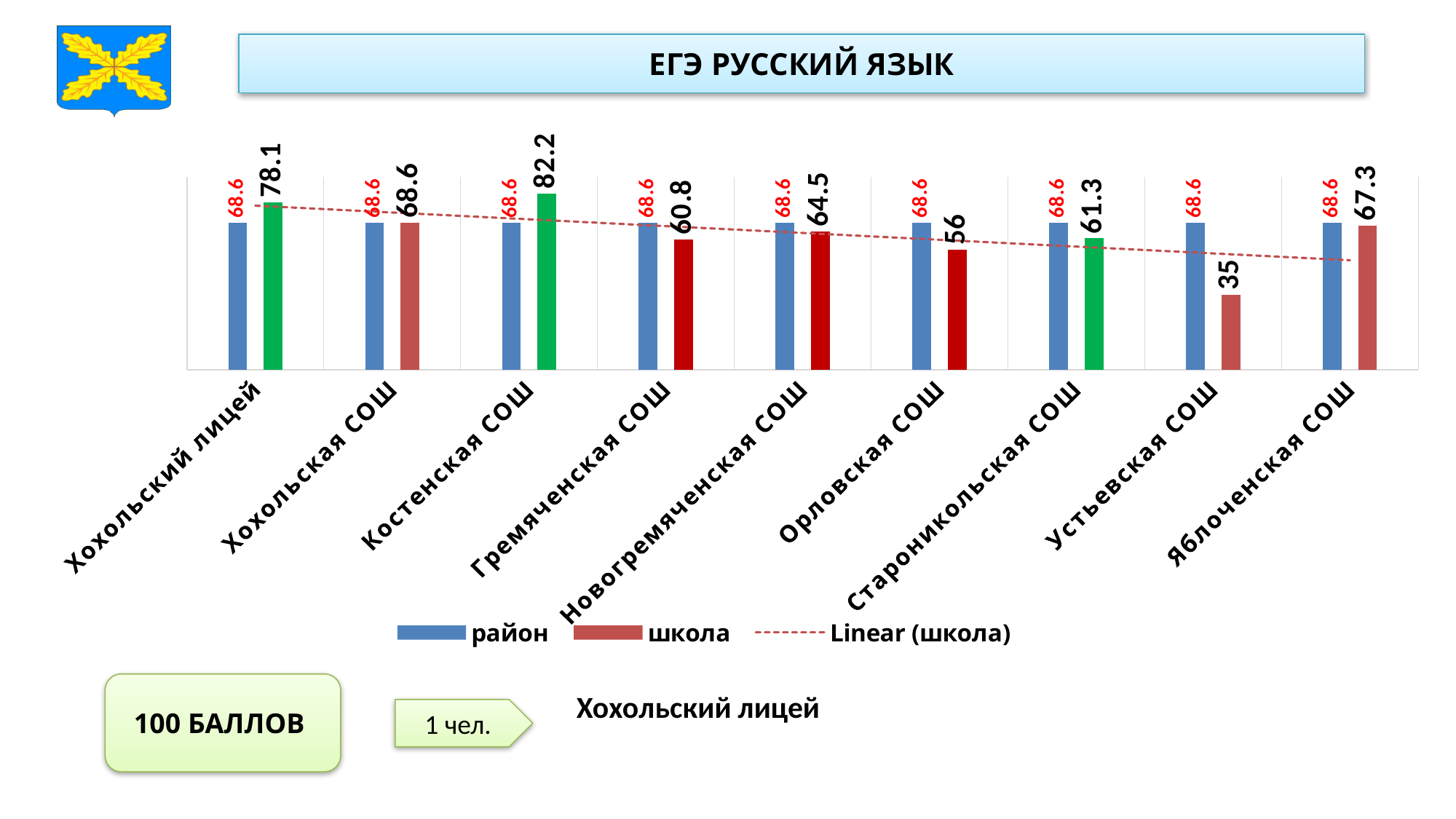
What is the школа value for Костенская СОШ? 82.2 What is the difference between the школа value for Яблоченская СОШ and the район value? 1.3 Which is larger, the школа value for Новогремяченская СОШ or for Гремяченская СОШ? Новогремяченская СОШ How many entries does the chart legend list? 3 Which school has the highest школа value? Костенская СОШ What is the район value shown for Орловская СОШ? 68.6 How many schools are shown on the x axis of the chart? 9 What is the title of the chart on the slide? ЕГЭ РУССКИЙ ЯЗЫК What kind of chart is shown on the slide? bar chart What is the школа value for Устьевская СОШ? 35 Which school has the lowest школа value? Устьевская СОШ What is the difference between the школа values for Хохольский лицей and Орловская СОШ? 22.1